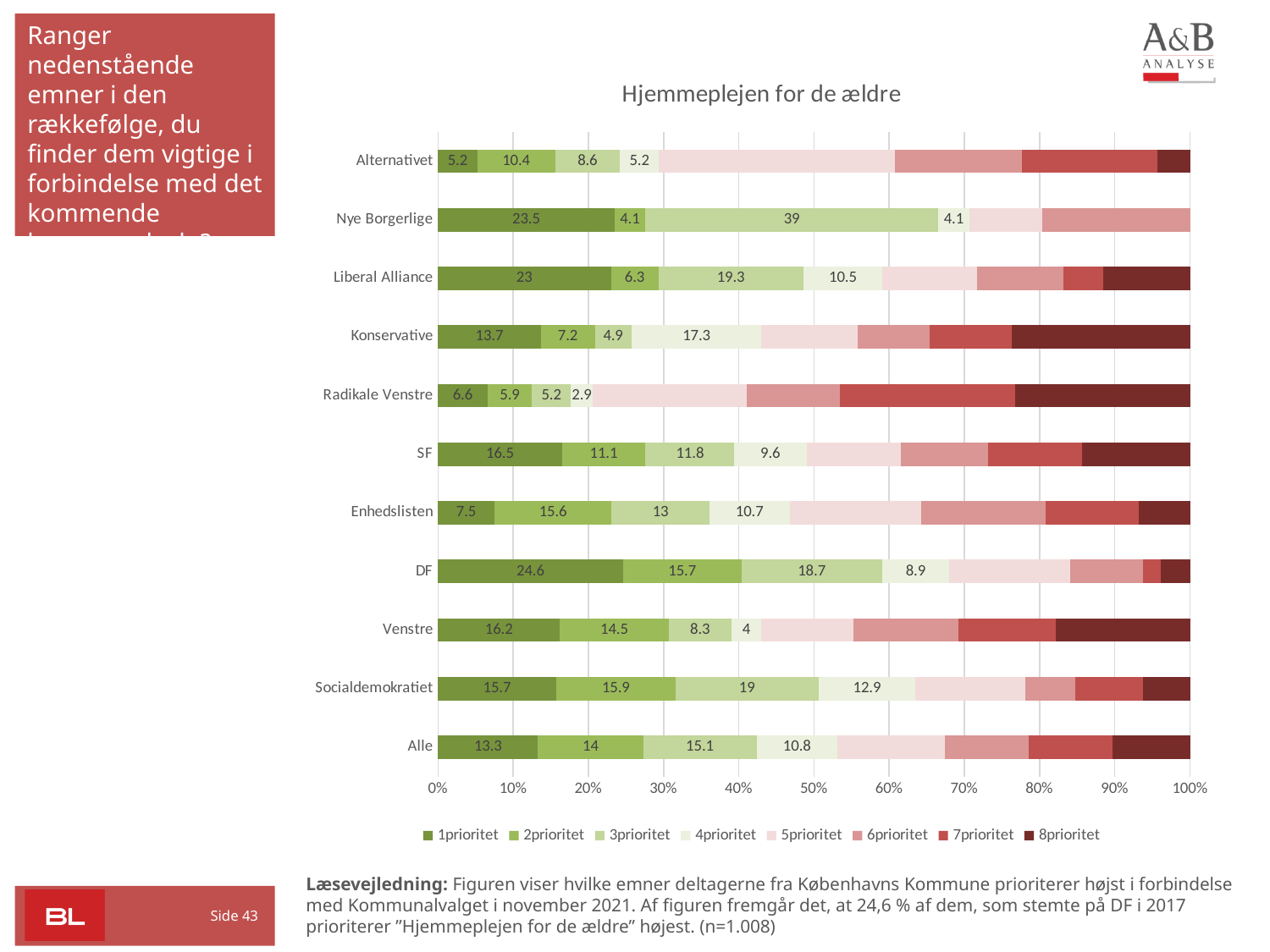
What is the difference between the 1prioritet value for DF and the 1prioritet value for Alle? 11.3 Which category has the lowest 1prioritet value? Alternativet Which category has the highest 1prioritet value? DF Which has the larger 2prioritet value, Socialdemokratiet or Venstre? Socialdemokratiet What is the 3prioritet value for Nye Borgerlige? 39 How many categories (parties/groups) are shown on the vertical axis? 11 Is the 8prioritet value for Konservative greater or less than 20%? greater What type of chart is shown on the slide? Stacked bar chart What is the 1prioritet value for DF? 24.6 What is the title of the chart? Hjemmeplejen for de ældre How many series does the legend list? 8 What is the 4prioritet value for Konservative? 17.3